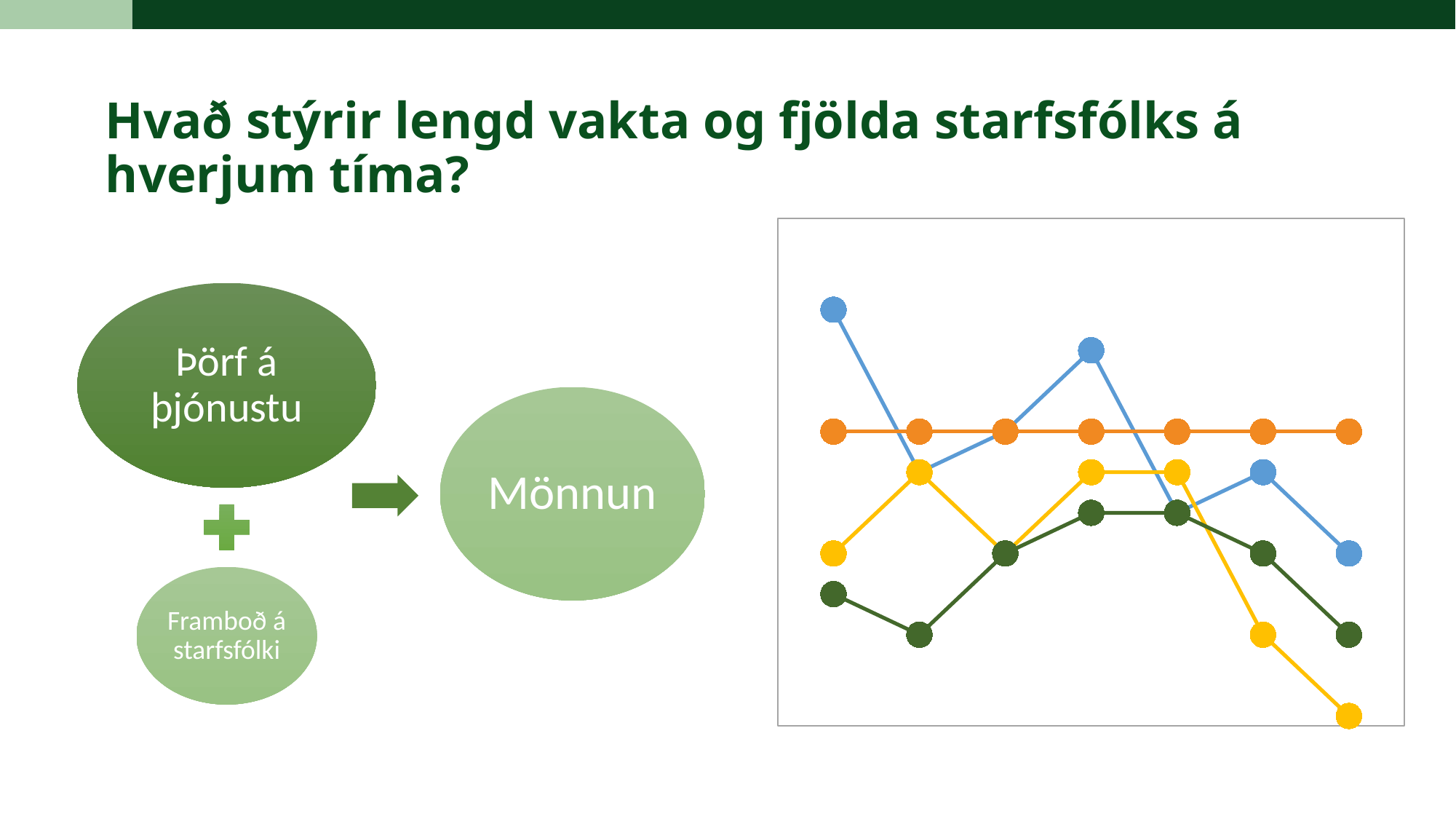
What kind of chart is shown on the right side of the slide? line chart Which coloured line has the lowest final point on the right of the chart? yellow Does the orange line rise, fall, or stay flat across the chart? stays flat Does the chart display a legend or axis labels? no Does the yellow line rise or fall between its last two points? fall How many points does each line in the chart have? 7 Which coloured line ends highest at the right edge of the chart? orange Which coloured line stays flat across the whole chart? orange Which coloured line has the highest first point on the left of the chart? blue Which coloured line has the lowest first point on the left of the chart? dark green How many lines are plotted in the chart? 4 Does the blue line rise or fall from its first point to its second point? fall